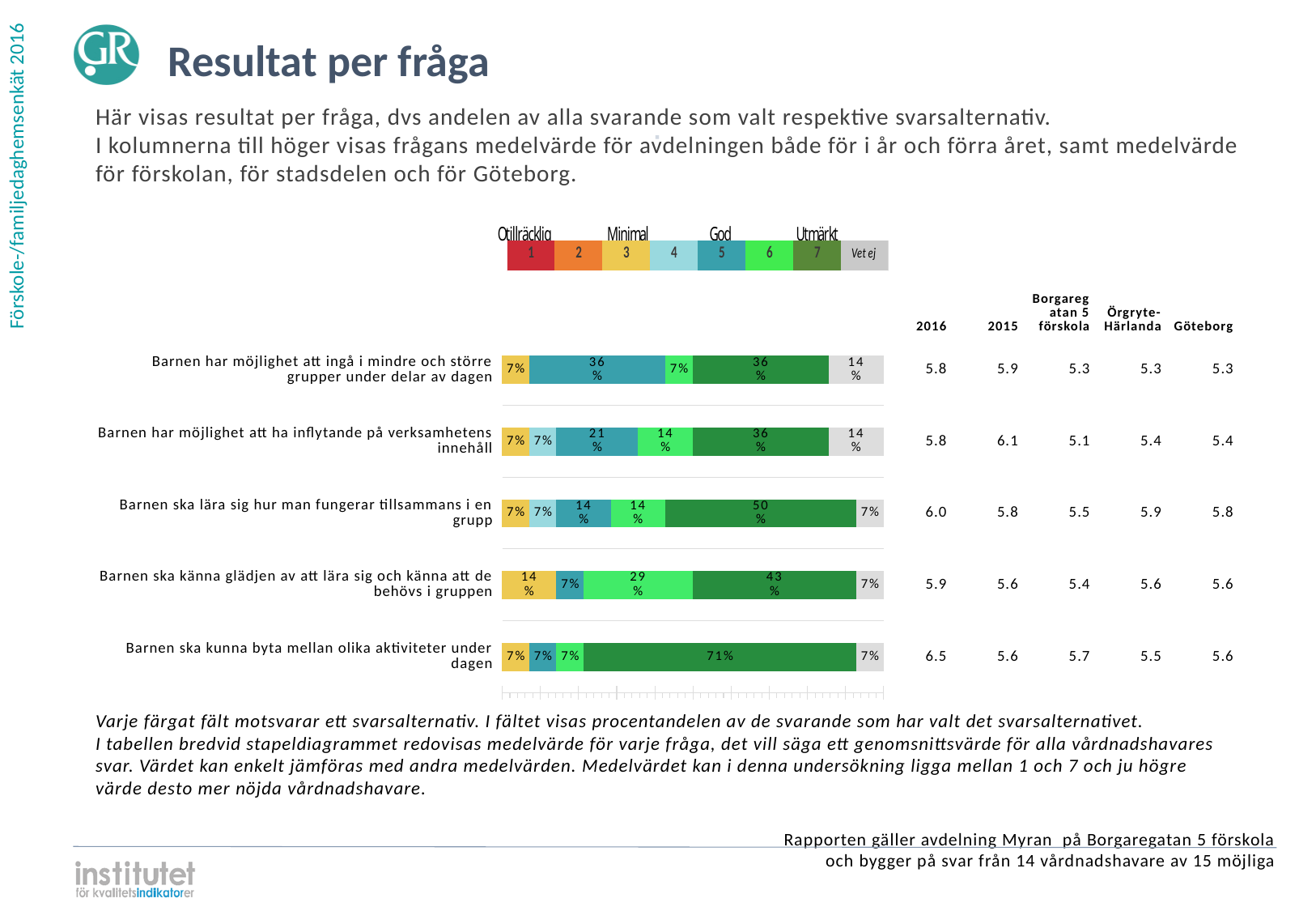
What percentage of respondents chose 'Utmärkt' (7, dark green) for 'Barnen ska kunna byta mellan olika aktiviteter under dagen'? 71% Which is larger: the dark green (7) share for 'Barnen har möjlighet att ingå i mindre och större grupper under delar av dagen' or for 'Barnen ska lära sig hur man fungerar tillsammans i en grupp'? Barnen ska lära sig hur man fungerar tillsammans i en grupp What percentage chose answer 5 (teal) for 'Barnen har möjlighet att ingå i mindre och större grupper under delar av dagen'? 36% How many questions (categories) are plotted in the bar chart? 5 What percentage chose answer 6 (light green) for 'Barnen ska känna glädjen av att lära sig och känna att de behövs i gruppen'? 29% What type of chart is shown on the slide? Stacked bar chart What is the 2016 mean value for 'Barnen ska kunna byta mellan olika aktiviteter under dagen' in the table next to the chart? 6.5 What percentage chose 'Vet ej' for 'Barnen har möjlighet att ha inflytande på verksamhetens innehåll'? 14% What label does the legend give to the grey answer alternative at the right end of each bar? Vet ej How many answer alternatives does the colour legend above the chart list? 8 Which question has the largest share of 'Utmärkt' (7, dark green) responses? Barnen ska kunna byta mellan olika aktiviteter under dagen What is the difference between the dark green (7) share for 'Barnen ska lära sig hur man fungerar tillsammans i en grupp' and for 'Barnen ska känna glädjen av att lära sig och känna att de behövs i gruppen'? 7 percentage points